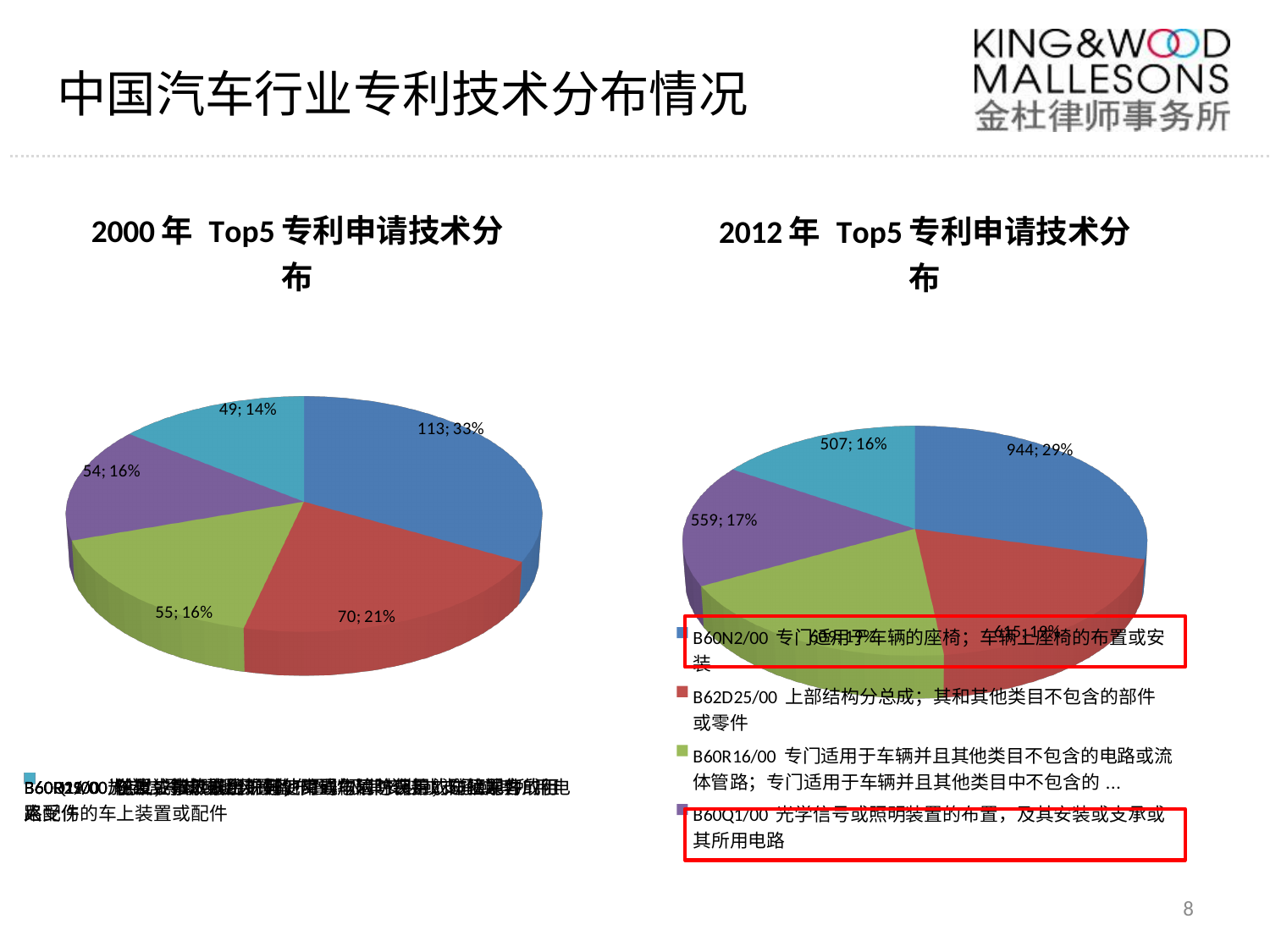
In the right chart (2012年 Top5 专利申请技术分布), what share of the pie does B60Q1/00 have? 17% What is the title of the right chart? 2012年 Top5 专利申请技术分布 In the left chart (2000年 Top5 专利申请技术分布), what is the value and share of the smallest slice? 49; 14% In the left chart (2000年 Top5 专利申请技术分布), what is the difference between the largest slice (113) and the second largest slice (70)? 43 How many slices does the left chart (2000年 Top5 专利申请技术分布) have? 5 What kind of chart is the left chart titled 2000年 Top5 专利申请技术分布? pie chart In the right chart (2012年 Top5 专利申请技术分布), what colour represents B62D25/00 in the legend? red In the right chart (2012年 Top5 专利申请技术分布), what is the value for B60N2/00? 944 In the left chart (2000年 Top5 专利申请技术分布), what is the total of all five slice values? 341 In the right chart (2012年 Top5 专利申请技术分布), what is the difference between the values for B60N2/00 and B60Q1/00? 385 In the left chart (2000年 Top5 专利申请技术分布), what is the value and share of the largest slice? 113; 33% In the right chart (2012年 Top5 专利申请技术分布), which is larger, B60N2/00 or B60Q1/00? B60N2/00